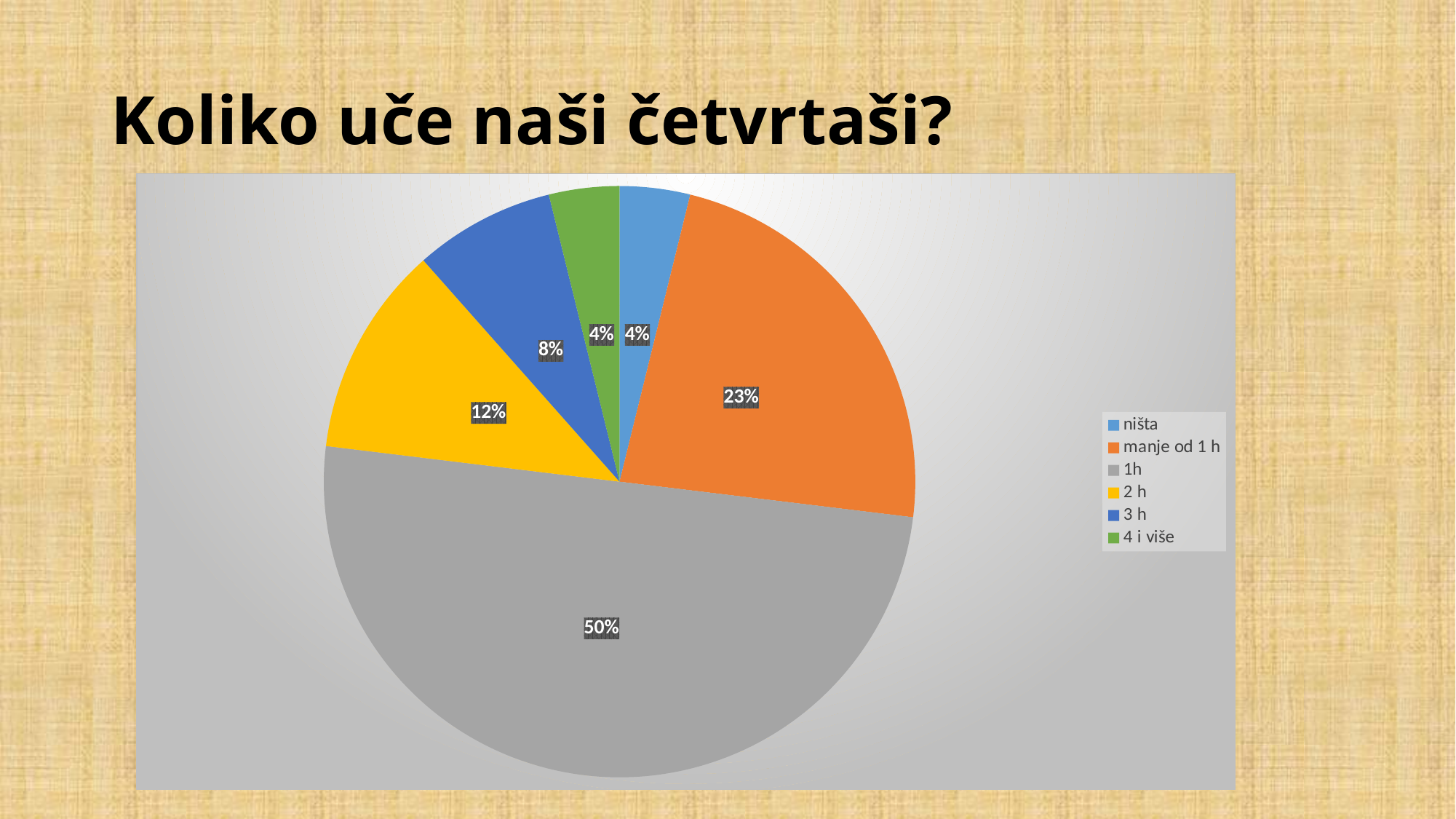
What share of the pie does the "1h" slice represent? 50% What is the title of the slide containing the chart? Koliko uče naši četvrtaši? What share of the pie does the "3 h" slice represent? 8% What share of the pie does the "manje od 1 h" slice represent? 23% What kind of chart is shown on the slide? pie chart Which category has the largest slice of the pie? 1h Which slice is larger, "2 h" or "3 h"? 2 h What colour is the "4 i više" slice? green How many categories does the legend list? 6 What is the difference in percentage points between the "1h" slice and the "manje od 1 h" slice? 27